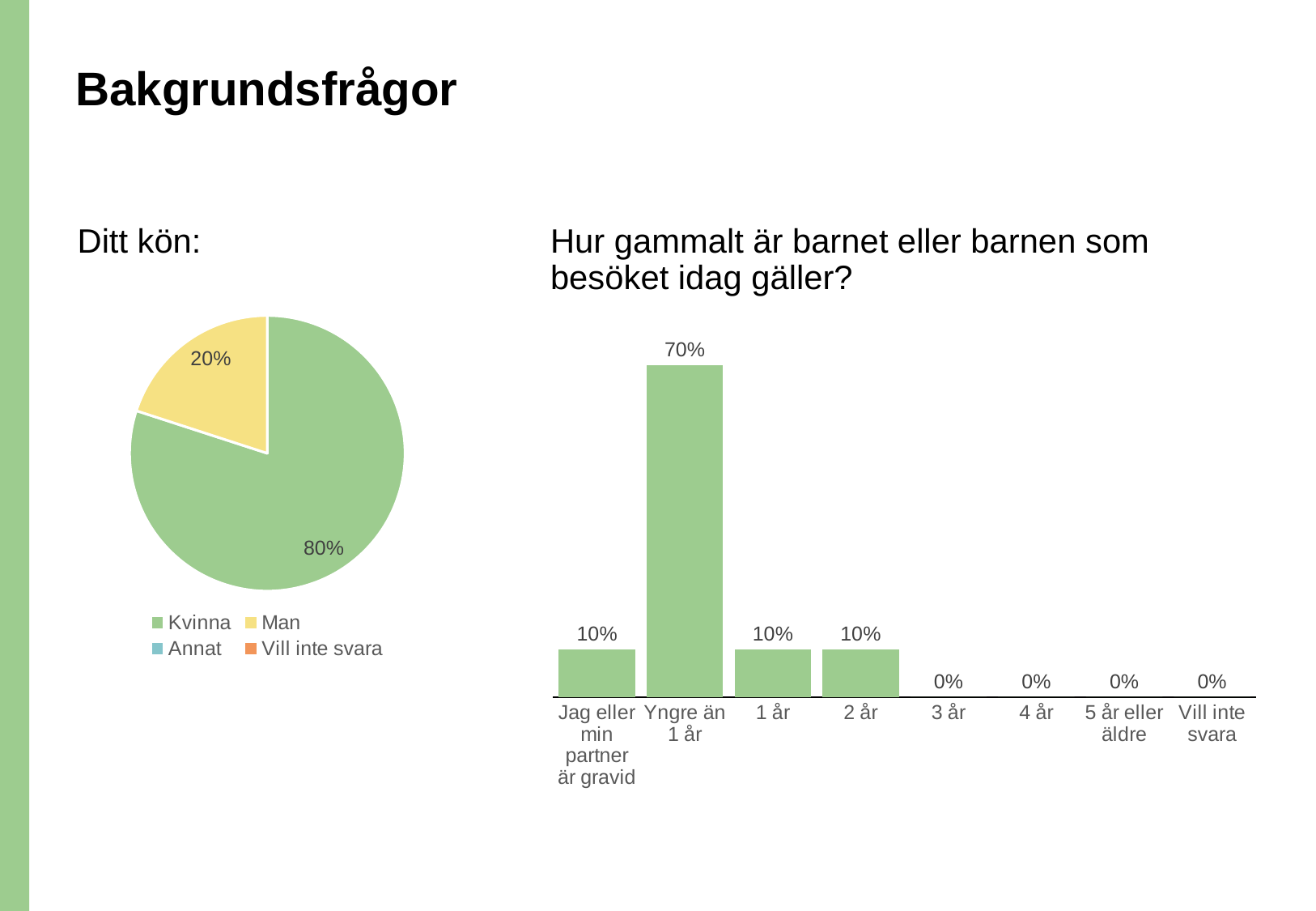
In the 'Ditt kön:' pie chart, how many entries does the legend list? 4 In the 'Hur gammalt är barnet eller barnen som besöket idag gäller?' chart, what is the value for '4 år'? 0% In the 'Hur gammalt är barnet eller barnen som besöket idag gäller?' chart, what is the difference between 'Yngre än 1 år' and '1 år'? 60% In the 'Ditt kön:' pie chart, what is the difference between the Kvinna and Man shares? 60% What kind of chart is the 'Hur gammalt är barnet eller barnen som besöket idag gäller?' chart? bar chart In the 'Ditt kön:' pie chart, what share is labelled for Man? 20% In the 'Hur gammalt är barnet eller barnen som besöket idag gäller?' chart, what is the value for '2 år'? 10% In the 'Ditt kön:' pie chart, which category has the largest slice? Kvinna In the 'Ditt kön:' pie chart, what share is labelled for Kvinna? 80% In the 'Hur gammalt är barnet eller barnen som besöket idag gäller?' chart, which category has the highest value? Yngre än 1 år In the 'Hur gammalt är barnet eller barnen som besöket idag gäller?' chart, what is the value for 'Yngre än 1 år'? 70% In the 'Hur gammalt är barnet eller barnen som besöket idag gäller?' chart, how many categories are shown on the x axis? 8